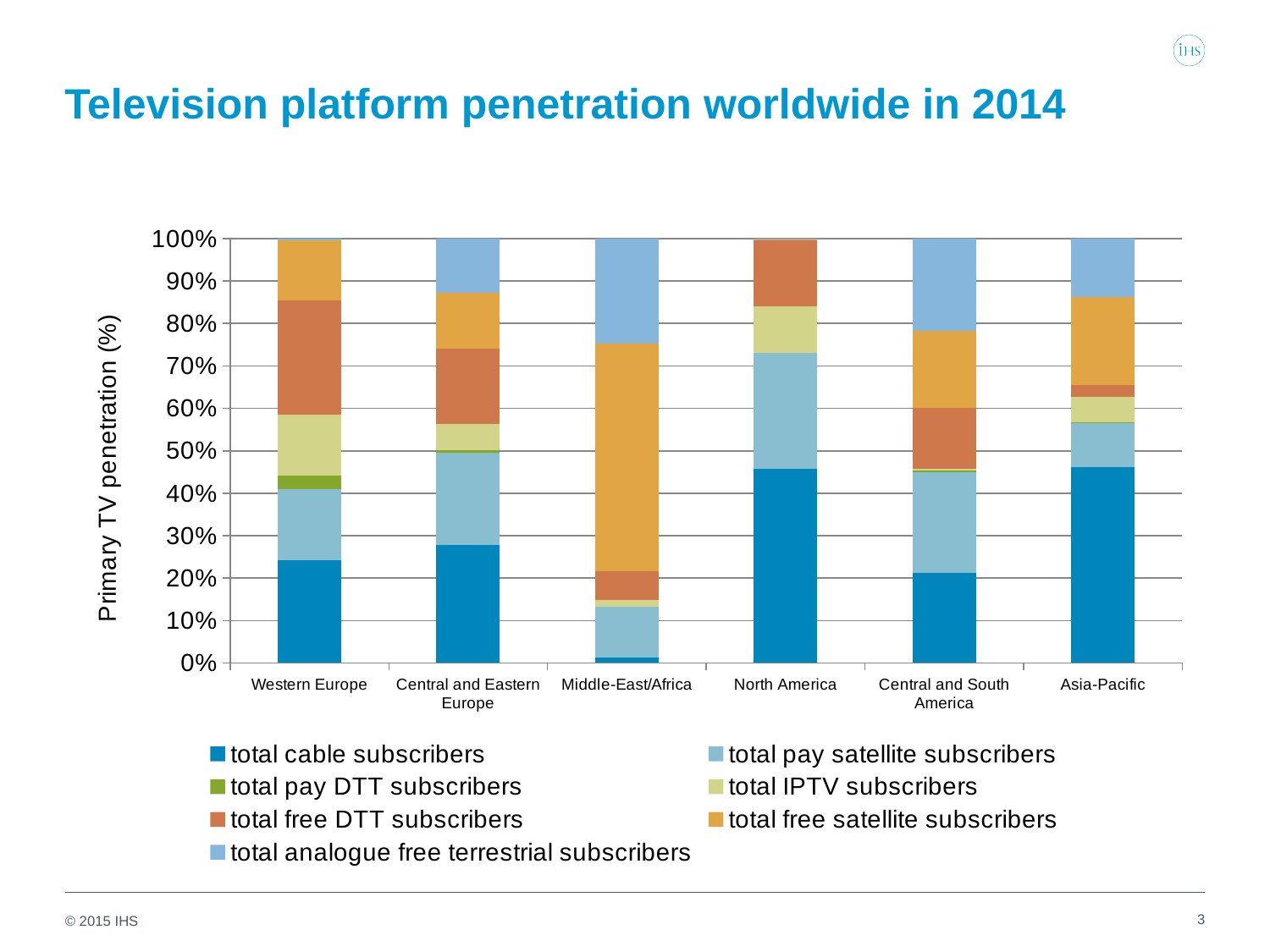
Which region has a larger total cable subscribers segment, North America or Central and South America? North America How many series does the legend list? 7 Which region has a larger total pay satellite subscribers segment, Central and South America or Asia-Pacific? Central and South America Is the total cable subscribers value for North America greater or less than 40%? greater How many regions are shown on the x axis of the chart? 6 Is the total cable subscribers value for Western Europe greater or less than 20%? greater Which region has the smallest total cable subscribers segment? Middle-East/Africa Which region has the largest total free satellite subscribers segment? Middle-East/Africa Is the total cable subscribers value for Middle-East/Africa greater or less than 10%? less What kind of chart is shown on the slide? Stacked bar chart What is the title of the slide? Television platform penetration worldwide in 2014 What is the label on the y axis of the chart? Primary TV penetration (%)